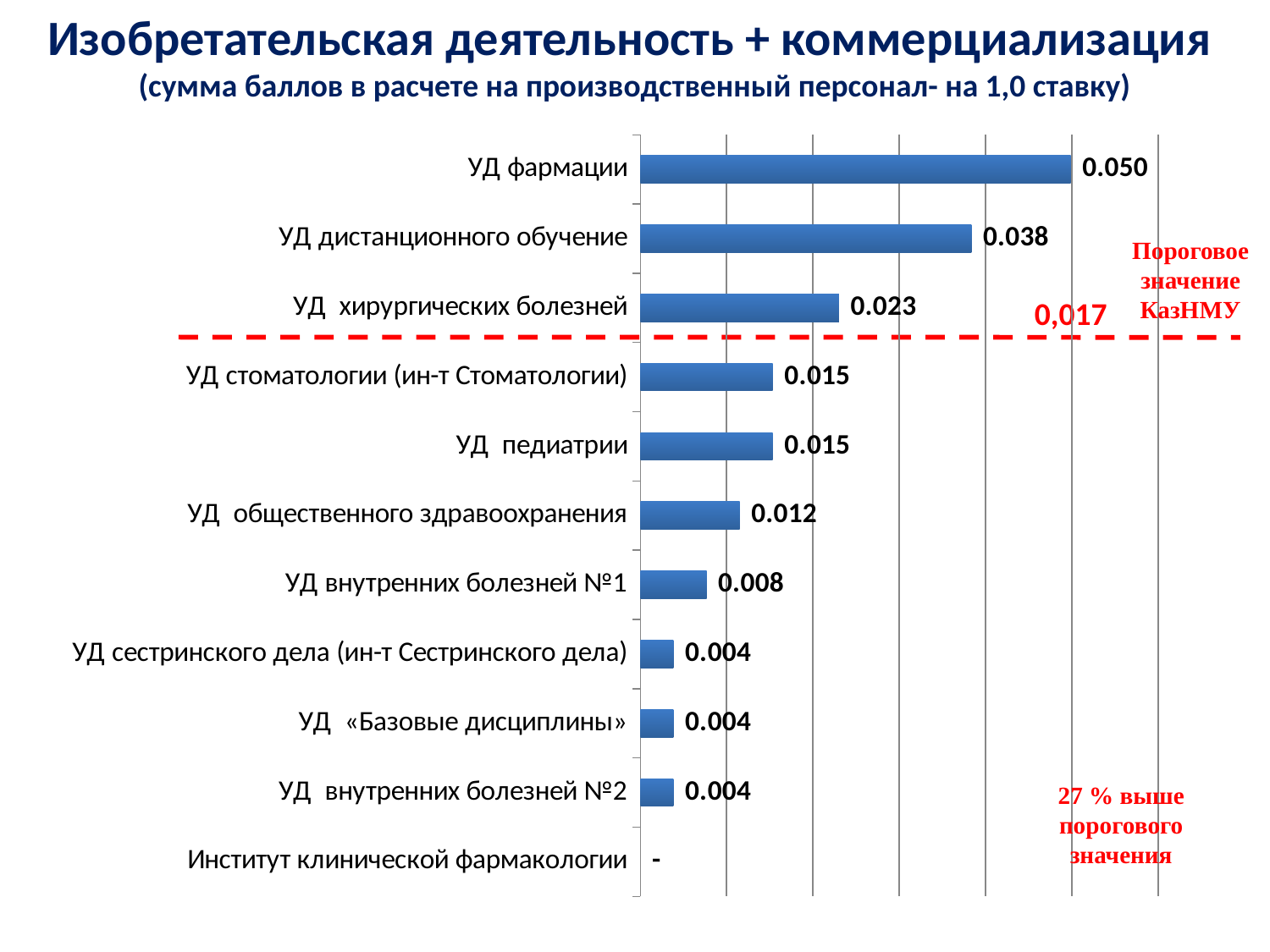
How many categories have a value of 0.004? 3 Which category has the highest value? УД фармации How many categories are listed on the chart? 11 What is the value for УД внутренних болезней №1? 0.008 What is the value for УД общественного здравоохранения? 0.012 What is the difference between the values for УД фармации and УД дистанционного обучение? 0.012 What is the value for УД хирургических болезней? 0.023 What is the value for УД фармации? 0.050 What threshold value (Пороговое значение КазНМУ) is marked by the red dashed line? 0,017 Which is larger, the value for УД педиатрии or the value for УД внутренних болезней №1? УД педиатрии What kind of chart is shown on the slide? Bar chart What is the difference between the values for УД хирургических болезней and УД стоматологии (ин-т Стоматологии)? 0.008